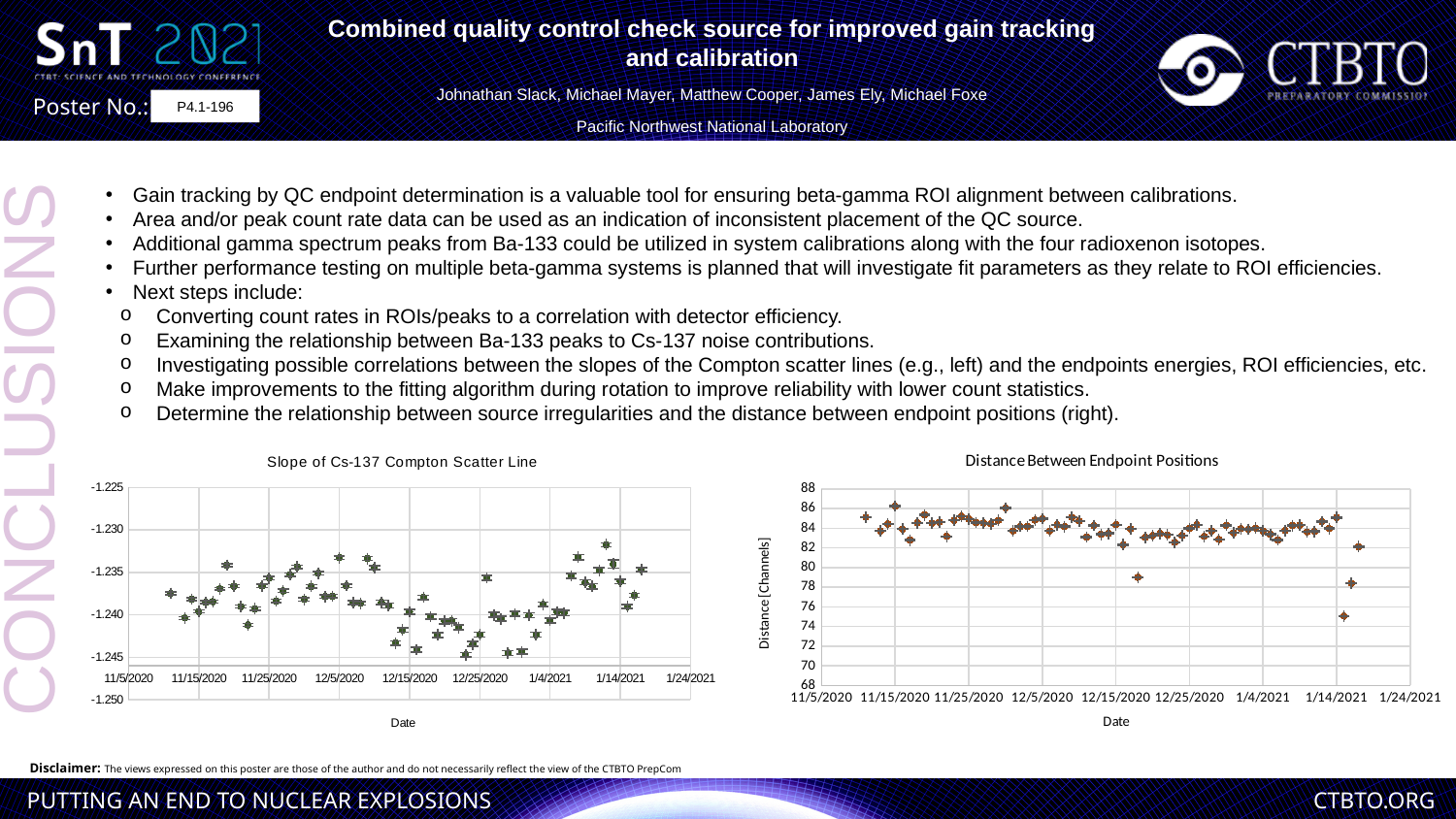
On the right chart, 'Distance Between Endpoint Positions', is the highest plotted value greater or less than 84? greater On the left chart, 'Slope of Cs-137 Compton Scatter Line', do the values generally rise or fall between 12/5/2020 and 12/20/2020? fall What is the y-axis label of the right chart, 'Distance Between Endpoint Positions'? Distance [Channels] What is the title of the left chart on the slide? Slope of Cs-137 Compton Scatter Line On the left chart, 'Slope of Cs-137 Compton Scatter Line', is the lowest plotted value greater or less than -1.240? less On the right chart, 'Distance Between Endpoint Positions', is the lowest plotted value greater or less than 78? less On the left chart, 'Slope of Cs-137 Compton Scatter Line', do the values generally rise or fall between 12/25/2020 and 1/14/2021? rise What kind of chart is the left chart, 'Slope of Cs-137 Compton Scatter Line'? scatter chart What kind of chart is the right chart, 'Distance Between Endpoint Positions'? scatter chart